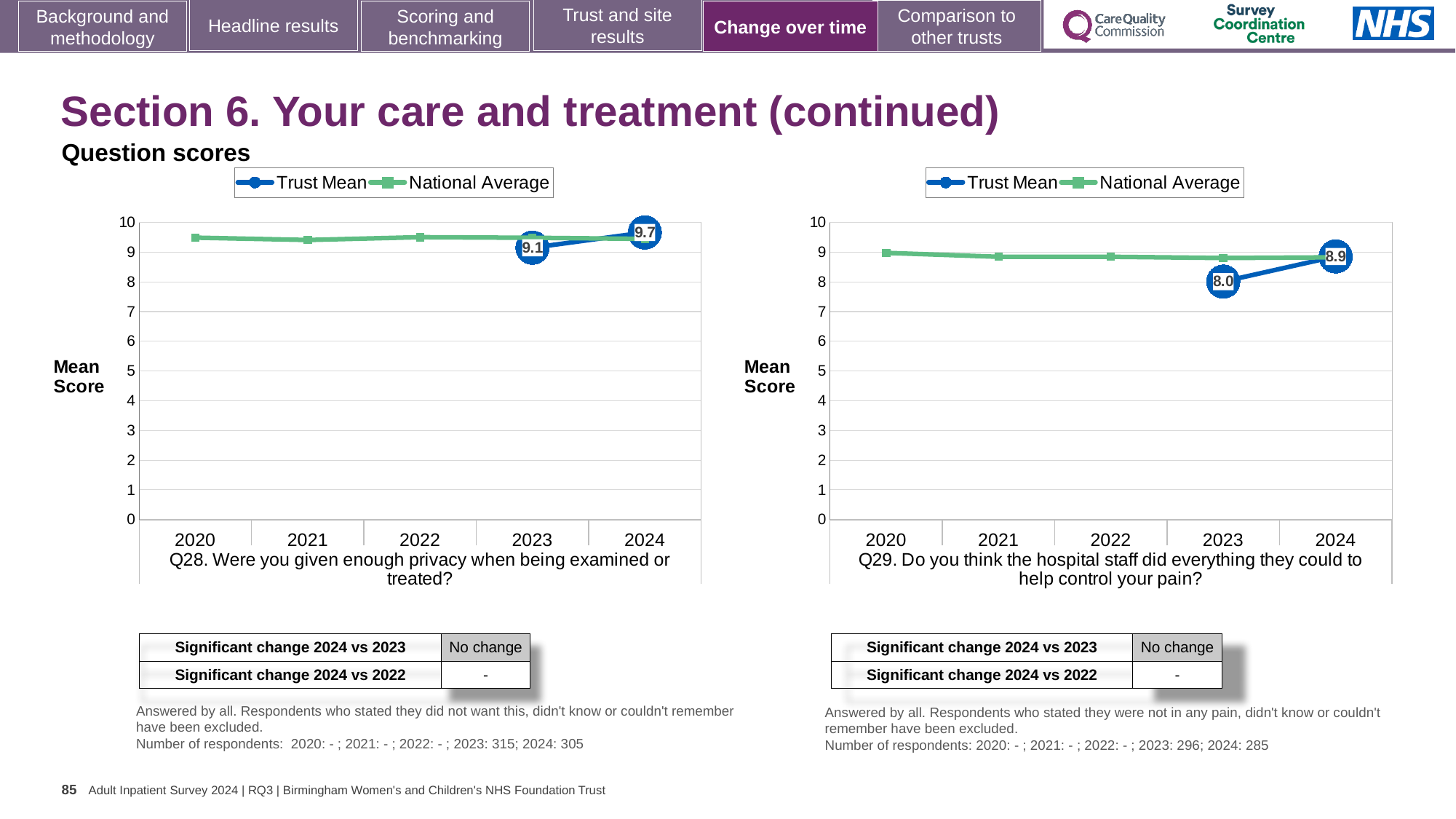
In the Q29 chart (right), what is the Trust Mean for 2024? 8.9 In the Q29 chart (right), is the National Average for 2023 greater or less than 8? greater In the Q28 chart (left), by how much did the Trust Mean change from 2023 to 2024? 0.6 In the Q28 chart (left), is the National Average for 2020 greater or less than 9? greater In the Q28 chart (left), what is the Trust Mean for 2024? 9.7 In the Q28 chart (left), what is the Trust Mean for 2023? 9.1 In the Q29 chart (right), what is the Trust Mean for 2023? 8.0 In the Q29 chart (right), which is larger in 2023: the Trust Mean or the National Average? National Average What kind of chart is the Q29 chart (right)? line chart In the Q29 chart (right), does the Trust Mean rise or fall from 2023 to 2024? rise How many series does the legend of the Q28 chart (left) list? 2 In the Q29 chart (right), what is the difference between the Trust Mean in 2024 and in 2023? 0.9